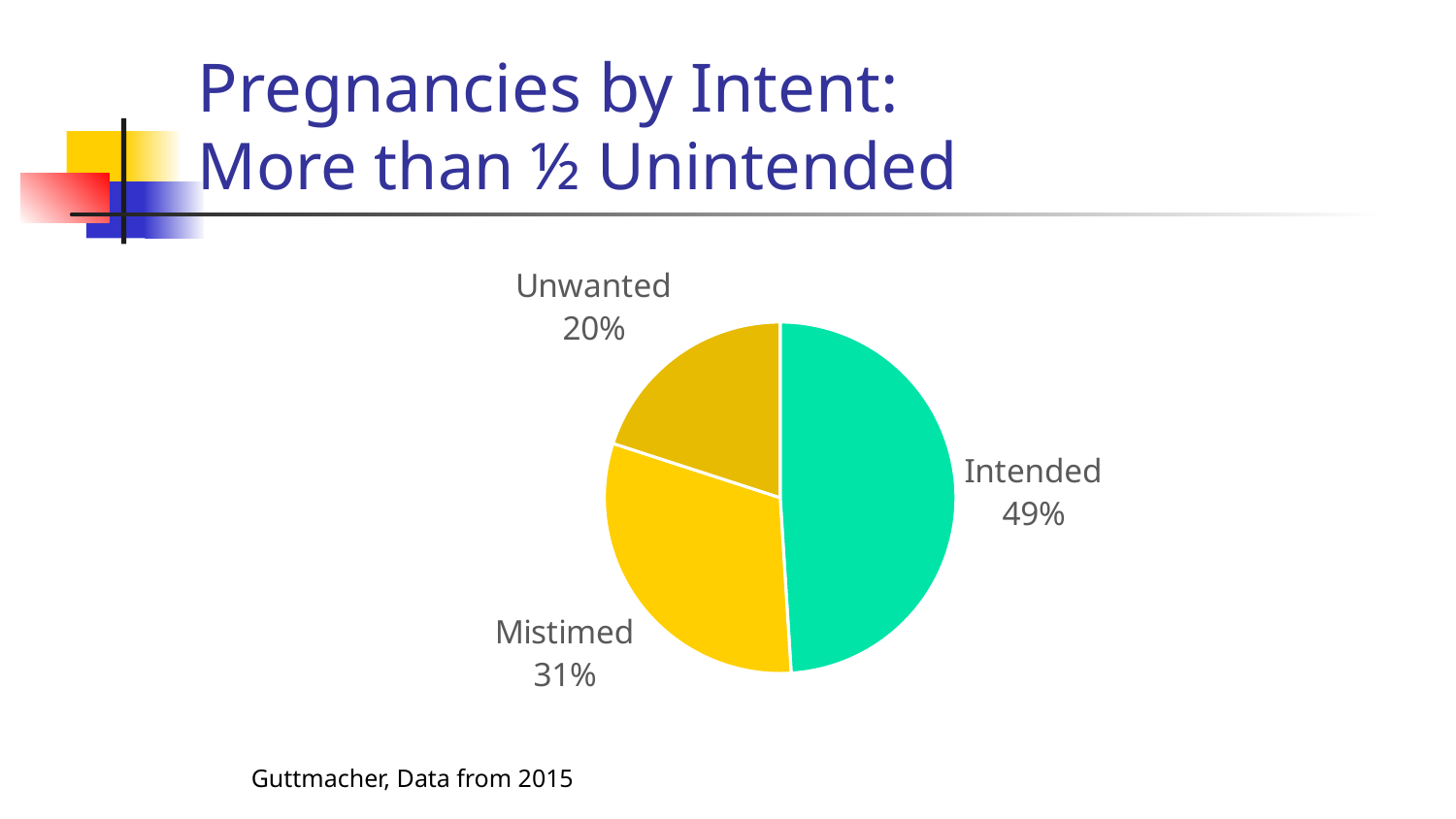
What share of pregnancies is labelled Mistimed? 31% What share of pregnancies is labelled Unwanted? 20% What share of pregnancies is labelled Intended? 49% How many slices does the pie chart have? 3 What kind of chart is shown on the slide? pie chart What is the title of the slide containing the pie chart? Pregnancies by Intent: More than ½ Unintended What is the difference in percentage points between the Intended and Mistimed slices? 18 Which is larger, the Mistimed slice or the Unwanted slice? Mistimed Which slice of the pie is the largest? Intended What is the difference in percentage points between the Mistimed and Unwanted slices? 11 What is the combined share of the Mistimed and Unwanted slices? 51% Which slice of the pie is the smallest? Unwanted